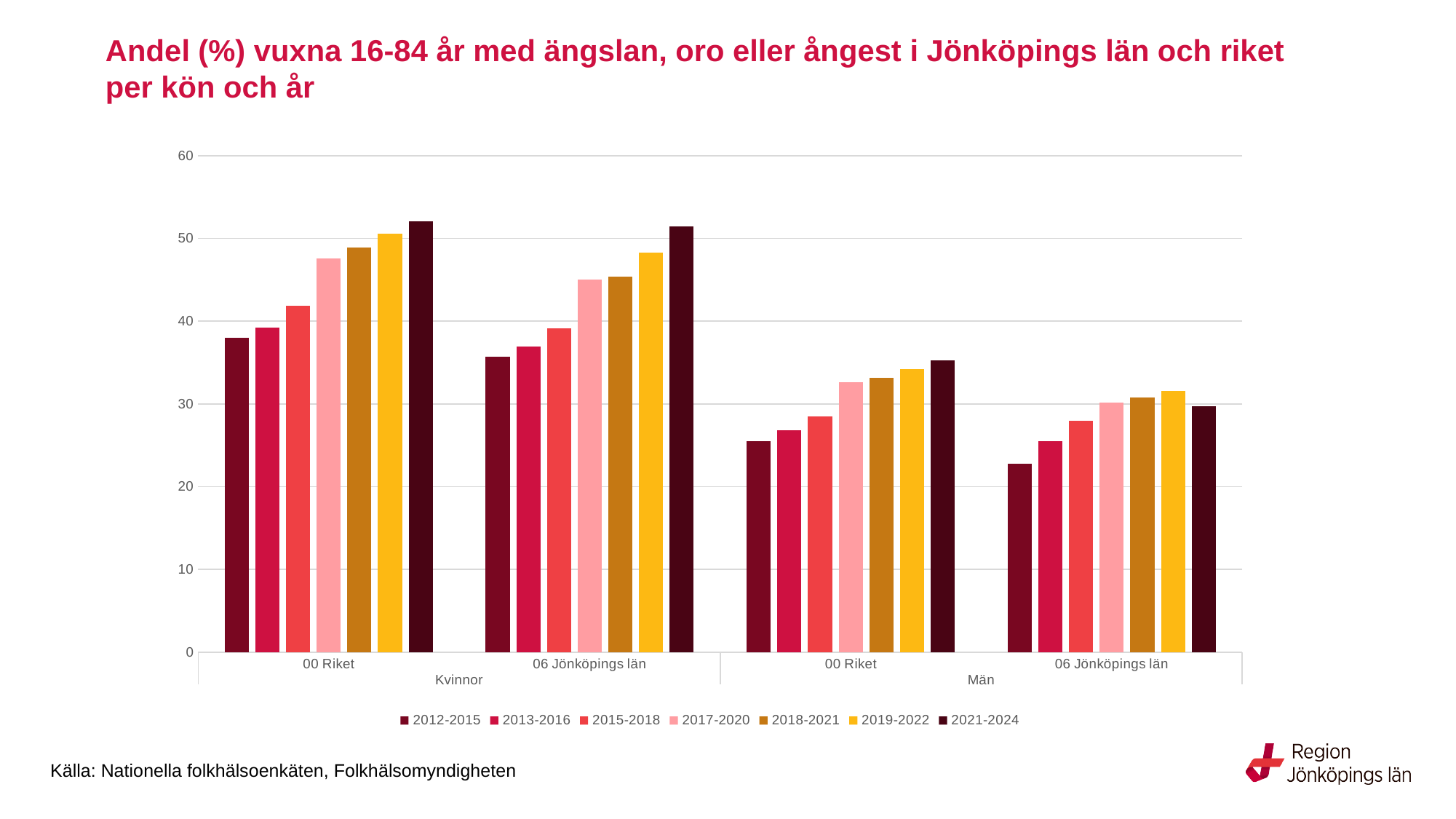
Within the Kvinnor 00 Riket group, which period has the highest value? 2021-2024 What is the first entry listed in the legend? 2012-2015 How many series (time periods) does the legend list? 7 Is the value for 2021-2024 in the Kvinnor 00 Riket group greater or less than 50? greater What kind of chart is shown on the slide? bar chart Within the Män 06 Jönköpings län group, which is larger: the value for 2019-2022 or for 2021-2024? 2019-2022 Is the value for 2017-2020 in the Män 00 Riket group greater or less than 30? greater For 2021-2024 in 00 Riket, which is larger: the value for Kvinnor or for Män? Kvinnor Within the Män 06 Jönköpings län group, which period has the lowest value? 2012-2015 Is the value for 2012-2015 in the Män 06 Jönköpings län group greater or less than 30? less Within the Kvinnor 00 Riket group, do the values rise or fall from 2012-2015 to 2021-2024? rise How many category groups are shown along the x axis? 4